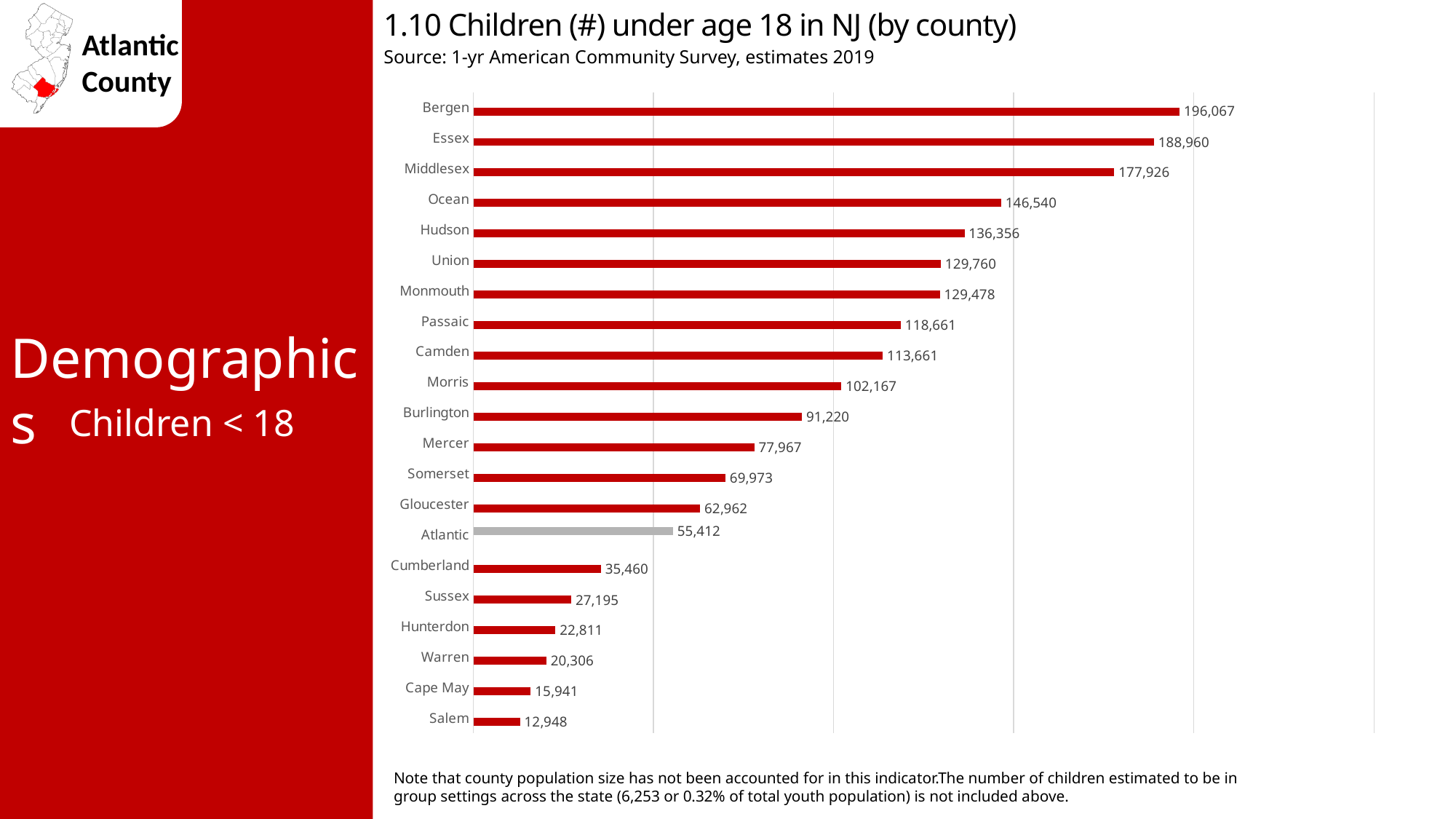
Which county has a larger value, Mercer or Somerset? Mercer Which county has a larger value, Ocean or Hudson? Ocean What type of chart is shown on the slide? bar chart Which county has the lowest number of children under age 18? Salem How many children under age 18 are shown for Atlantic County? 55,412 What is the difference between the values for Bergen and Essex? 7,107 What is the value shown for Cape May? 15,941 What is the difference between the values for Atlantic and Cumberland? 19,952 Which county has the highest number of children under age 18? Bergen What is the value shown for Middlesex? 177,926 Which county's bar is coloured grey instead of red? Atlantic How many counties are shown in the chart? 21